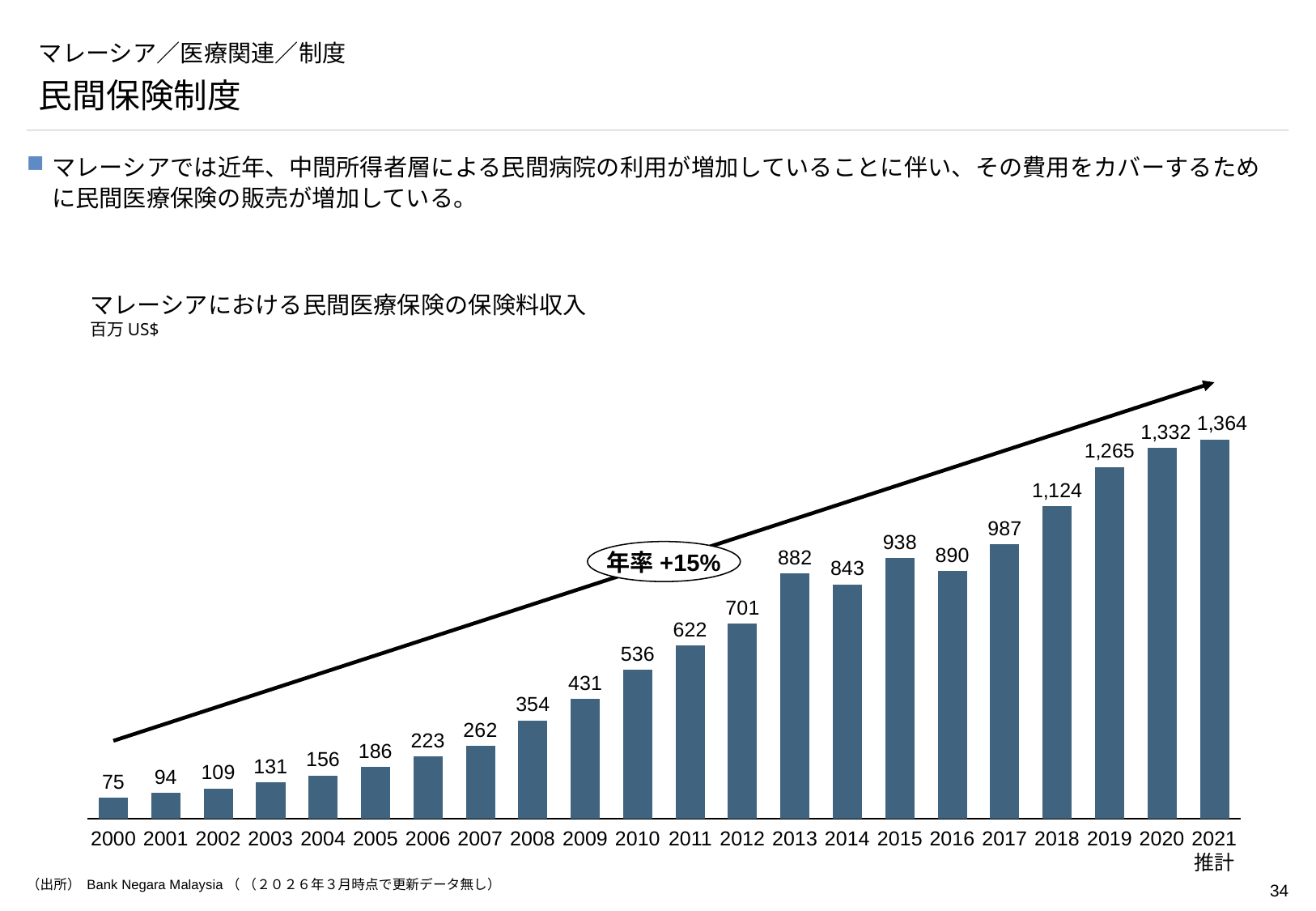
How many years are shown on the x axis? 22 What is the value for 2010? 536 Which is larger, the value for 2015 or the value for 2016? 2015 What is the difference between the values for 2013 and 2014? 39 What unit is stated under the chart title? 百万 US$ What annual growth rate is annotated on the chart? 年率 +15% What is the value for 2000? 75 What kind of chart is this? Bar chart Which year has the lowest value? 2000 What is the value for 2021 (推計)? 1,364 Which year has the highest value? 2021 Do the values generally rise or fall from 2000 to 2021? Rise